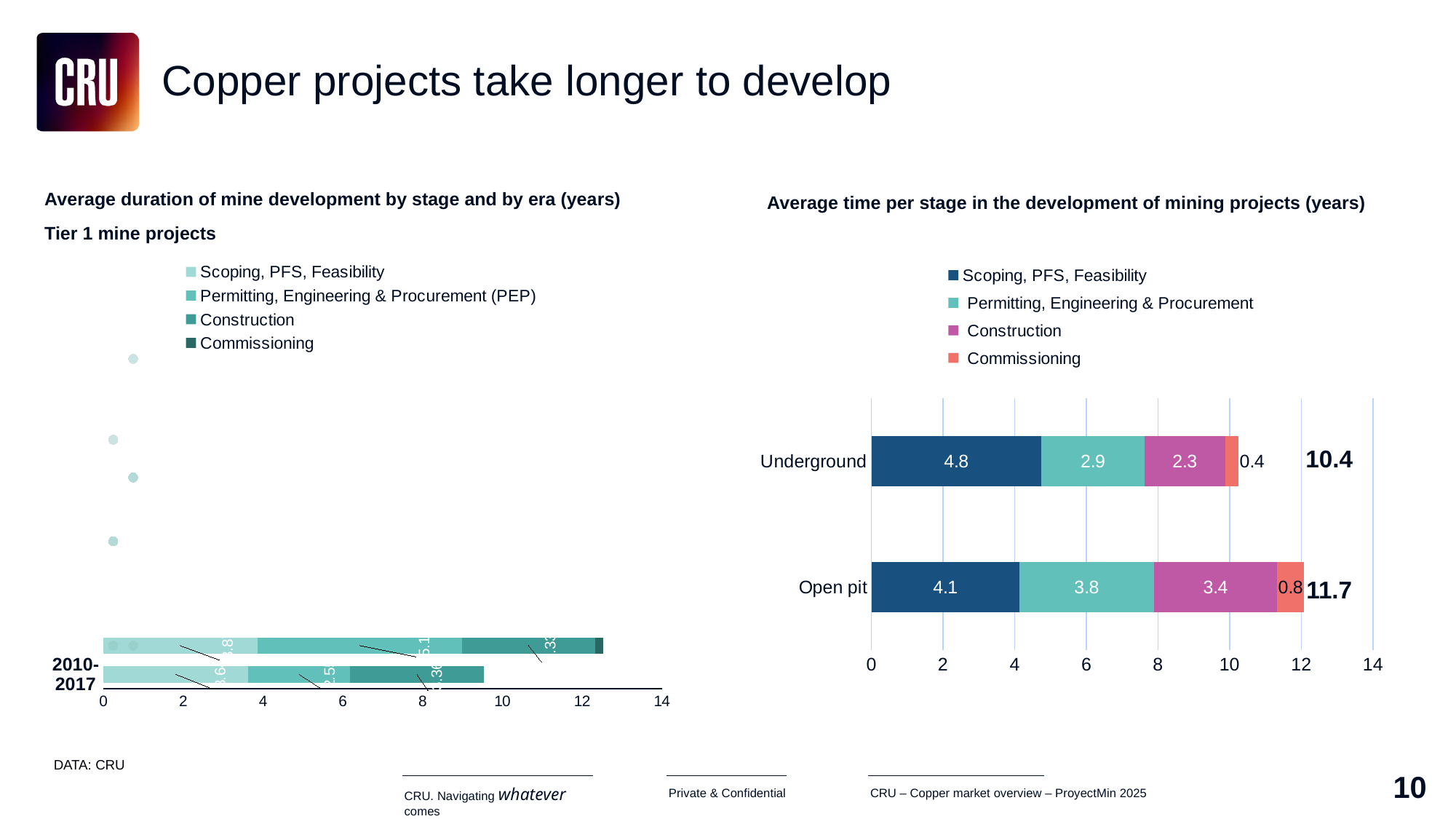
In the chart titled "Average time per stage in the development of mining projects (years)", what is the difference between the Permitting, Engineering & Procurement values for Open pit and Underground? 0.9 In the chart titled "Average time per stage in the development of mining projects (years)", what is the total duration shown for Open pit? 11.7 How many series does the legend list in the chart titled "Average time per stage in the development of mining projects (years)"? 4 What kind of chart is the one titled "Average time per stage in the development of mining projects (years)"? Stacked bar chart In the chart titled "Average time per stage in the development of mining projects (years)", what is the Commissioning value for Underground? 0.4 In the chart titled "Average time per stage in the development of mining projects (years)", what is the Scoping, PFS, Feasibility value for Underground? 4.8 In the chart titled "Average time per stage in the development of mining projects (years)", what is the Construction value for Open pit? 3.4 In the chart titled "Average time per stage in the development of mining projects (years)", what is the total duration shown for Underground? 10.4 In the chart titled "Average time per stage in the development of mining projects (years)", which has the larger Construction value, Underground or Open pit? Open pit In the chart titled "Average time per stage in the development of mining projects (years)", which stage is the longest for Underground? Scoping, PFS, Feasibility In the chart titled "Average time per stage in the development of mining projects (years)", which stage is the shortest for Open pit? Commissioning How many series does the legend list in the chart on the left titled "Average duration of mine development by stage and by era (years)"? 4